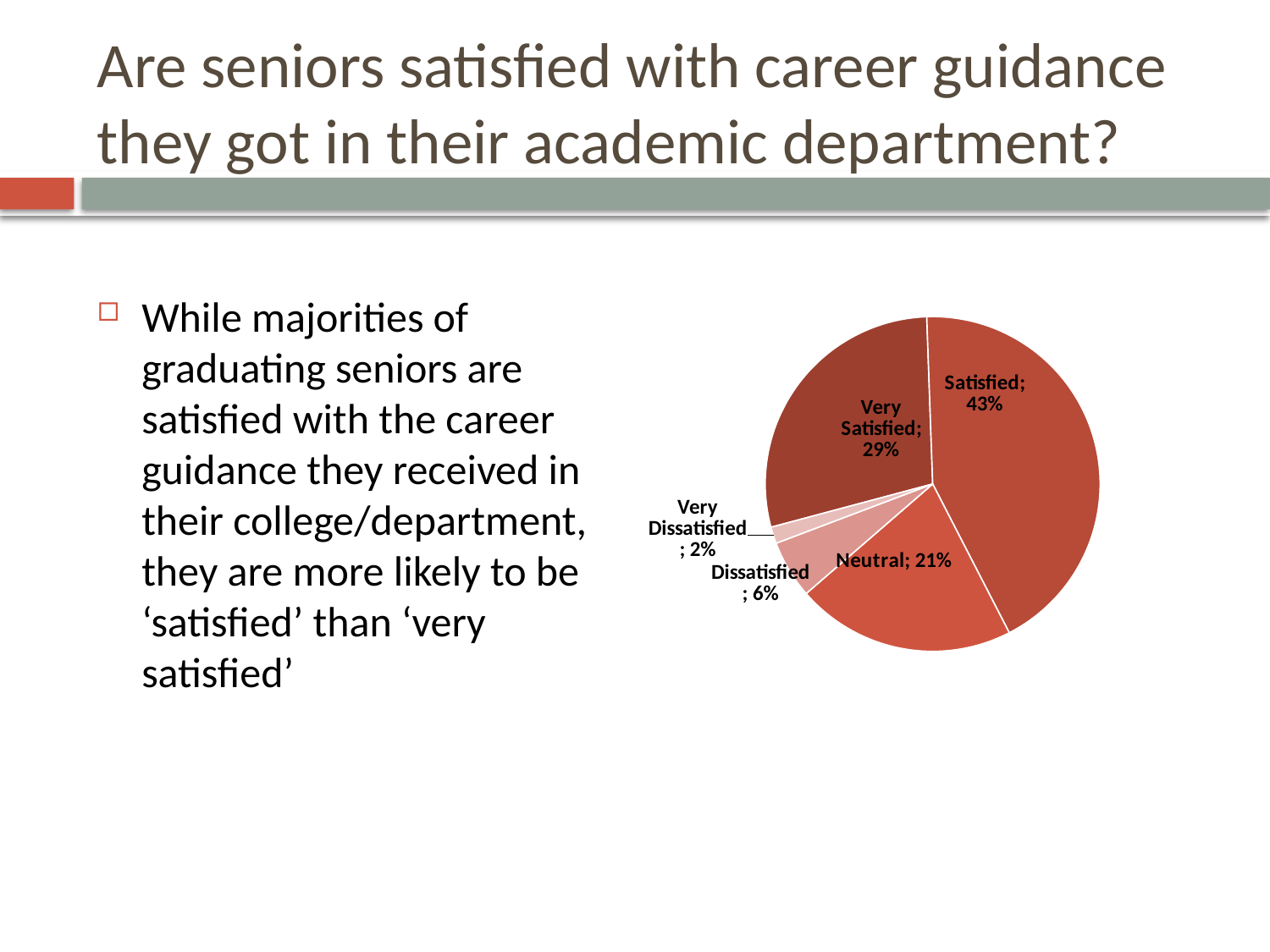
What is the difference in percentage points between 'Satisfied' and 'Very Satisfied'? 14 What percentage of seniors are 'Dissatisfied'? 6% What kind of chart is shown on the slide? Pie chart Which is larger, the share for 'Neutral' or the share for 'Dissatisfied'? Neutral Which category has the smallest share of the pie? Very Dissatisfied Which category has the largest share of the pie? Satisfied How many categories are shown in the pie chart? 5 What percentage of seniors are 'Neutral'? 21% What is the combined percentage of 'Satisfied' and 'Very Satisfied' seniors? 72% What percentage of seniors are 'Very Satisfied'? 29% What percentage of seniors are 'Satisfied' with the career guidance they received? 43% What percentage of seniors are 'Very Dissatisfied'? 2%